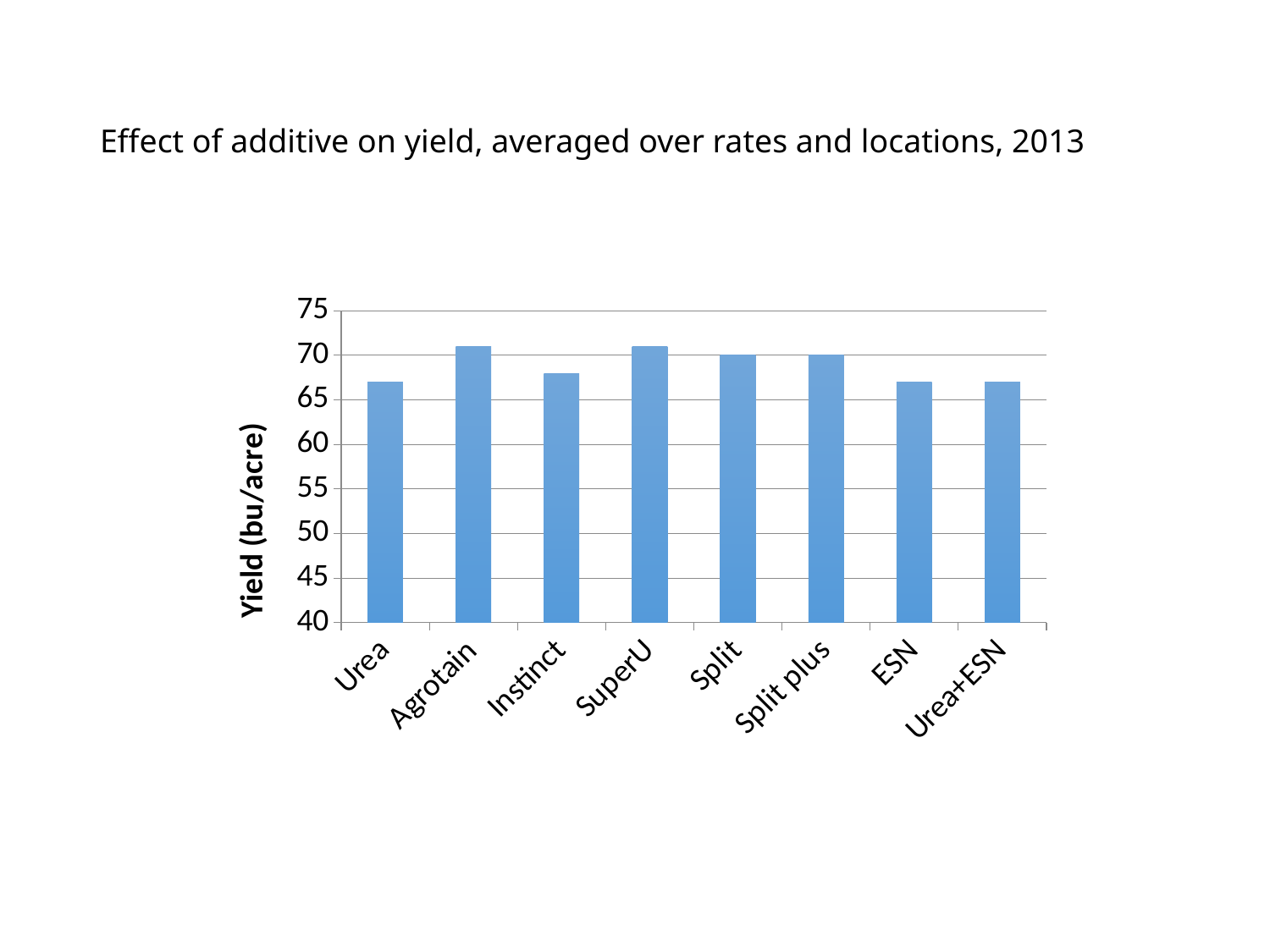
How many additive categories are shown on the x axis? 8 Is the value for Agrotain greater or less than 70? greater Is the value for Urea greater or less than 70? less What kind of chart is shown on the slide? bar chart Is the value for Instinct greater or less than 70? less What is the label of the y axis? Yield (bu/acre) Which has the larger yield, SuperU or ESN? SuperU Which has the larger yield, Agrotain or Urea? Agrotain What is the title of the chart? Effect of additive on yield, averaged over rates and locations, 2013 Which has the larger yield, Split or Urea+ESN? Split